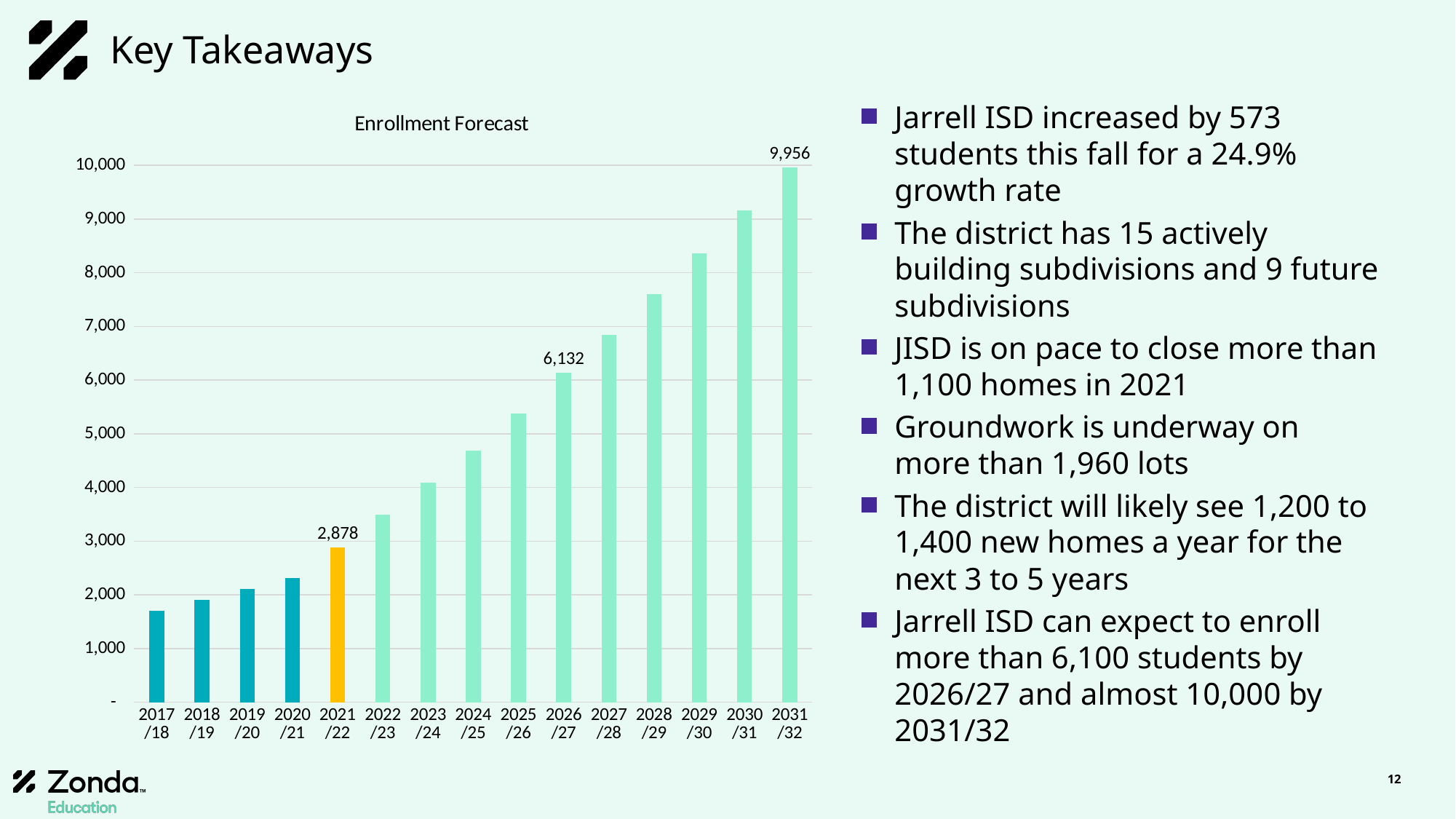
Which school year has the highest enrollment in the chart? 2031/32 What is the enrollment value shown for 2021/22? 2,878 What is the enrollment value shown for 2026/27? 6,132 Which school year has the lowest enrollment in the chart? 2017/18 What is the chart's title? Enrollment Forecast Do enrollment values rise or fall from 2017/18 to 2031/32? Rise How many school years are shown on the x axis? 15 What is the difference between the enrollment for 2026/27 and 2021/22? 3,254 What is the difference between the enrollment for 2031/32 and 2026/27? 3,824 What kind of chart is shown on the slide? Bar chart What is the enrollment value shown for 2031/32? 9,956 Is the value for 2030/31 greater or less than 9,000? greater